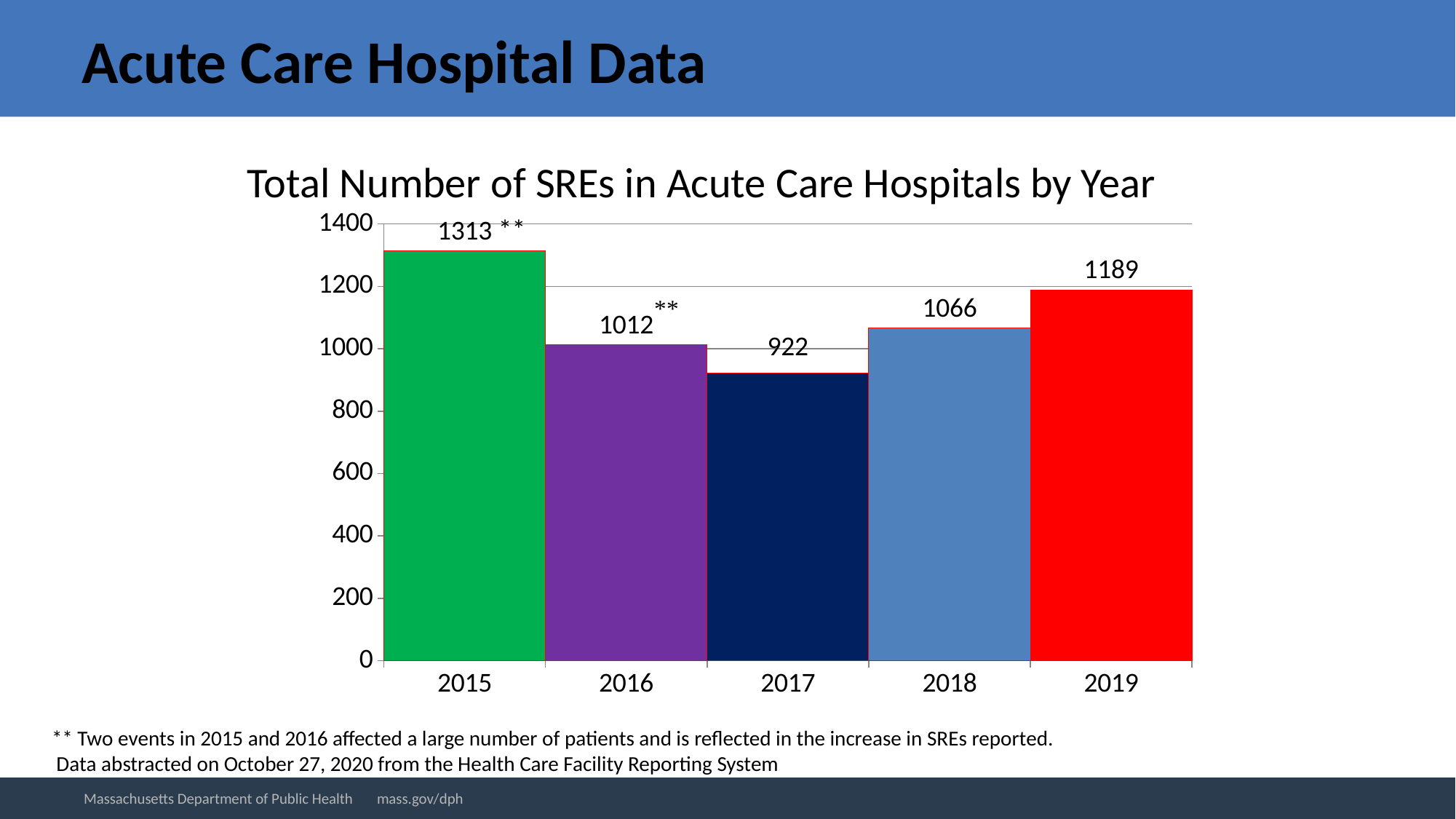
Is the value for 2018 greater or less than 1000? greater What is the difference between the number of SREs in 2015 and 2017? 391 What is the total number of SREs in acute care hospitals in 2017? 922 What is the difference between the number of SREs in 2019 and 2018? 123 What is the total number of SREs in acute care hospitals in 2016? 1012 Which year had more SREs, 2016 or 2018? 2018 What is the total number of SREs in acute care hospitals in 2019? 1189 Which year has the highest total number of SREs? 2015 How many years are shown on the chart? 5 What kind of chart is shown on the slide? Bar chart What is the title of the chart? Total Number of SREs in Acute Care Hospitals by Year Which year has the lowest total number of SREs? 2017